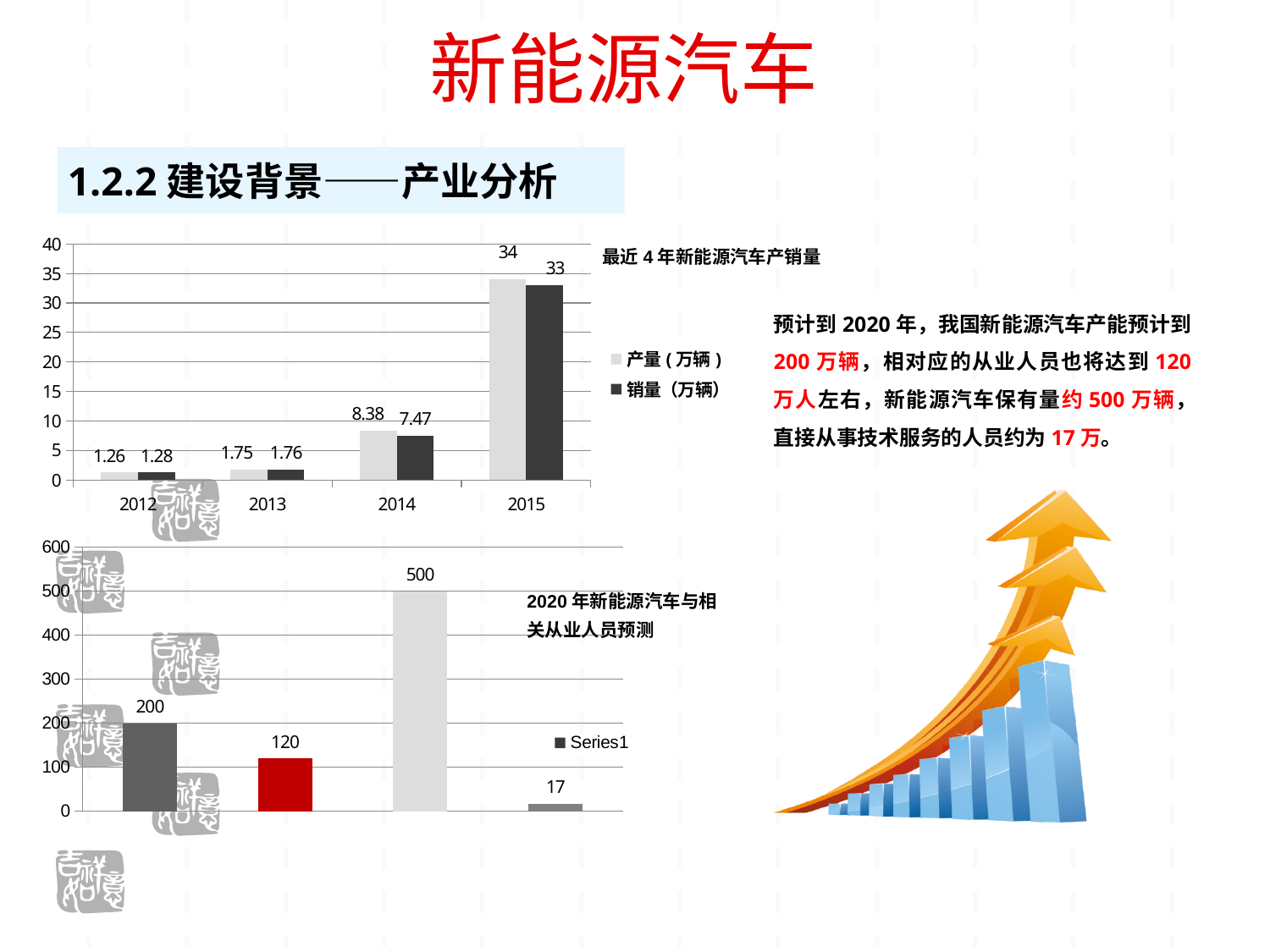
What kind of chart is the bottom chart (2020年新能源汽车与相关从业人员预测)? bar chart In the top chart (最近4年新能源汽车产销量), what is the 销量 (万辆) value for 2014? 7.47 In the top chart (最近4年新能源汽车产销量), what is the 产量 (万辆) value for 2012? 1.26 In the top chart (最近4年新能源汽车产销量), is the 产量 for 2014 larger or smaller than the 产量 for 2013? larger In the top chart (最近4年新能源汽车产销量), what is the difference between 产量 and 销量 in 2014? 0.91 In the top chart (最近4年新能源汽车产销量), which year has the lowest 产量 (万辆)? 2012 In the bottom chart (2020年新能源汽车与相关从业人员预测), what is the value of the tallest bar? 500 In the top chart (最近4年新能源汽车产销量), do the 产量 values rise or fall from 2012 to 2015? rise In the top chart (最近4年新能源汽车产销量), what is the 产量 (万辆) value for 2015? 34 In the top chart (最近4年新能源汽车产销量), how many series does the legend list? 2 In the top chart (最近4年新能源汽车产销量), which year has the highest 销量 (万辆)? 2015 In the bottom chart (2020年新能源汽车与相关从业人员预测), how many bars are plotted? 4